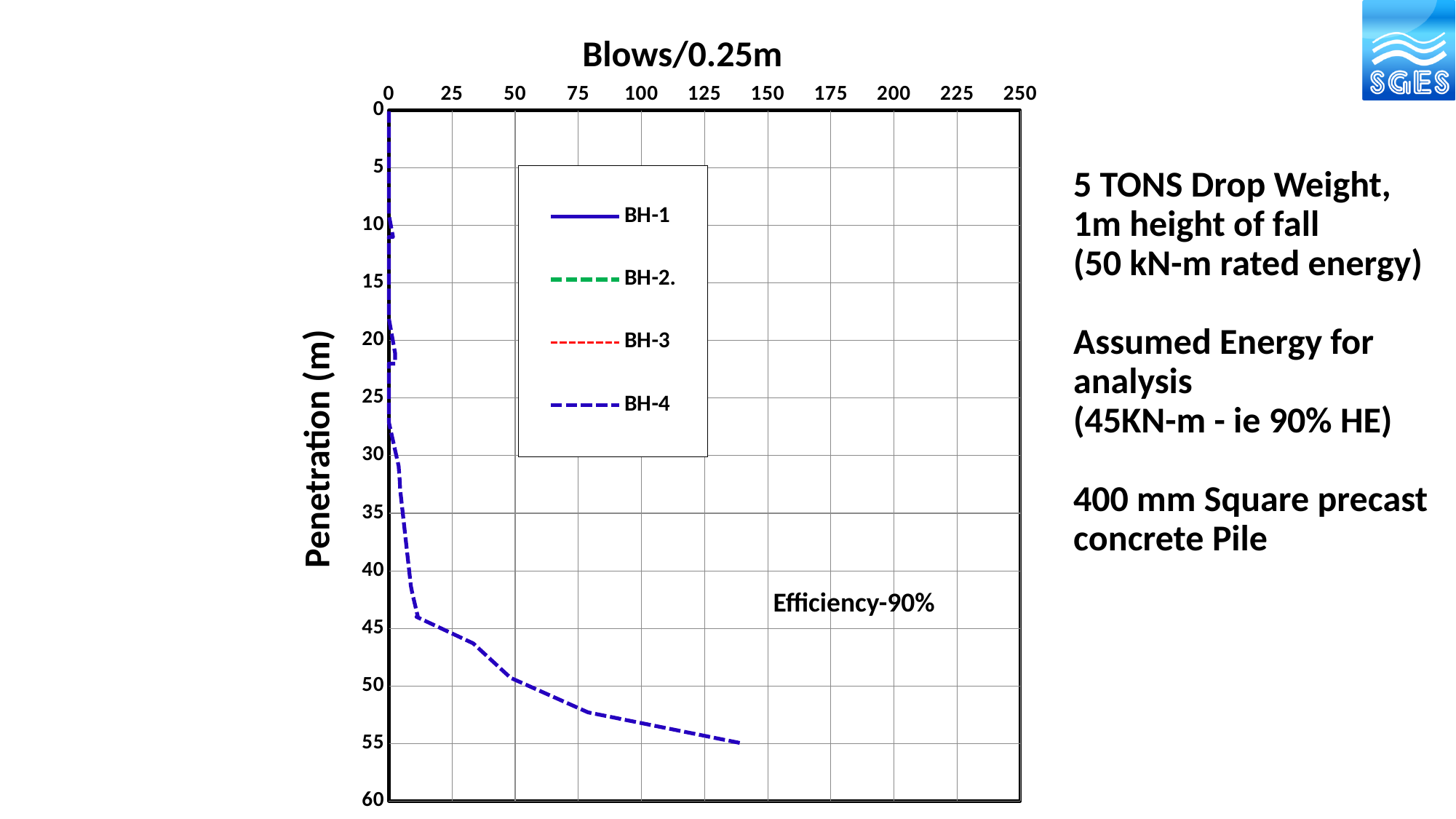
For BH-4, is the value at 55 m penetration greater or less than 125 blows/0.25m? greater For BH-4, is the value at about 52.5 m penetration greater or less than 75 blows/0.25m? greater How many series does the legend list? 4 For BH-4, is the value at 30 m penetration greater or less than 25 blows/0.25m? less What is the title of the vertical axis of the chart? Penetration (m) Does the number of blows for BH-4 increase or decrease as penetration depth increases below 40 m? increase What is the title of the horizontal axis of the chart? Blows/0.25m What kind of chart is shown on the slide? line chart Which series reaches the highest number of blows per 0.25 m? BH-4